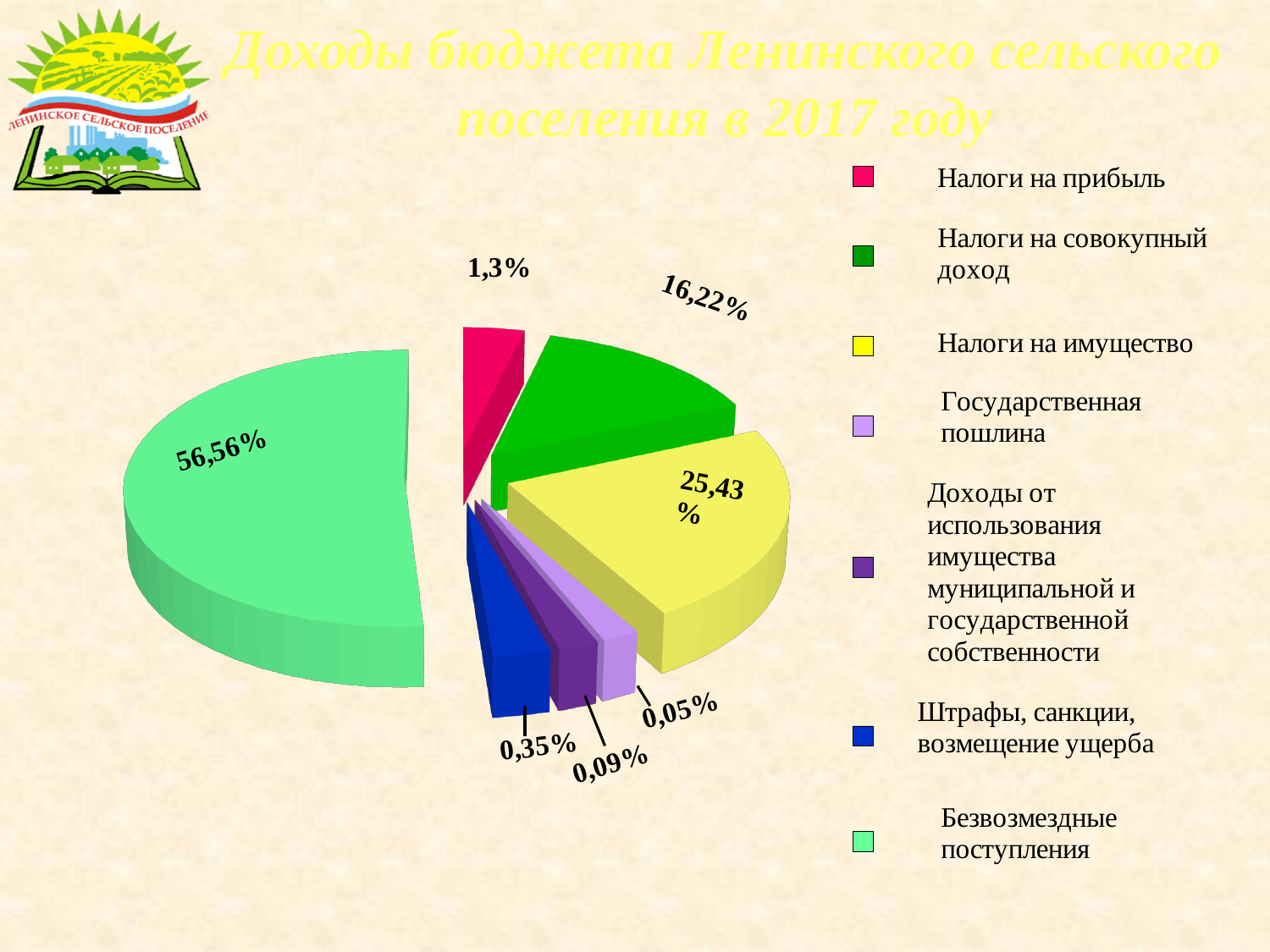
Which category has the largest share of the pie? Безвозмездные поступления What type of chart is shown on the slide? Pie chart What share of the pie does Безвозмездные поступления account for? 56,56% What is the value shown for Налоги на имущество? 25,43% What is the title of the chart? Доходы бюджета Ленинского сельского поселения в 2017 году Which category has the smallest share of the pie? Государственная пошлина What is the value shown for Штрафы, санкции, возмещение ущерба? 0,35% What is the difference between the shares of Налоги на имущество and Налоги на совокупный доход? 9,21% What is the value shown for Налоги на совокупный доход? 16,22% How many categories does the legend list? 7 Which is larger: the share for Налоги на прибыль or the share for Штрафы, санкции, возмещение ущерба? Налоги на прибыль What is the value shown for Государственная пошлина? 0,05%